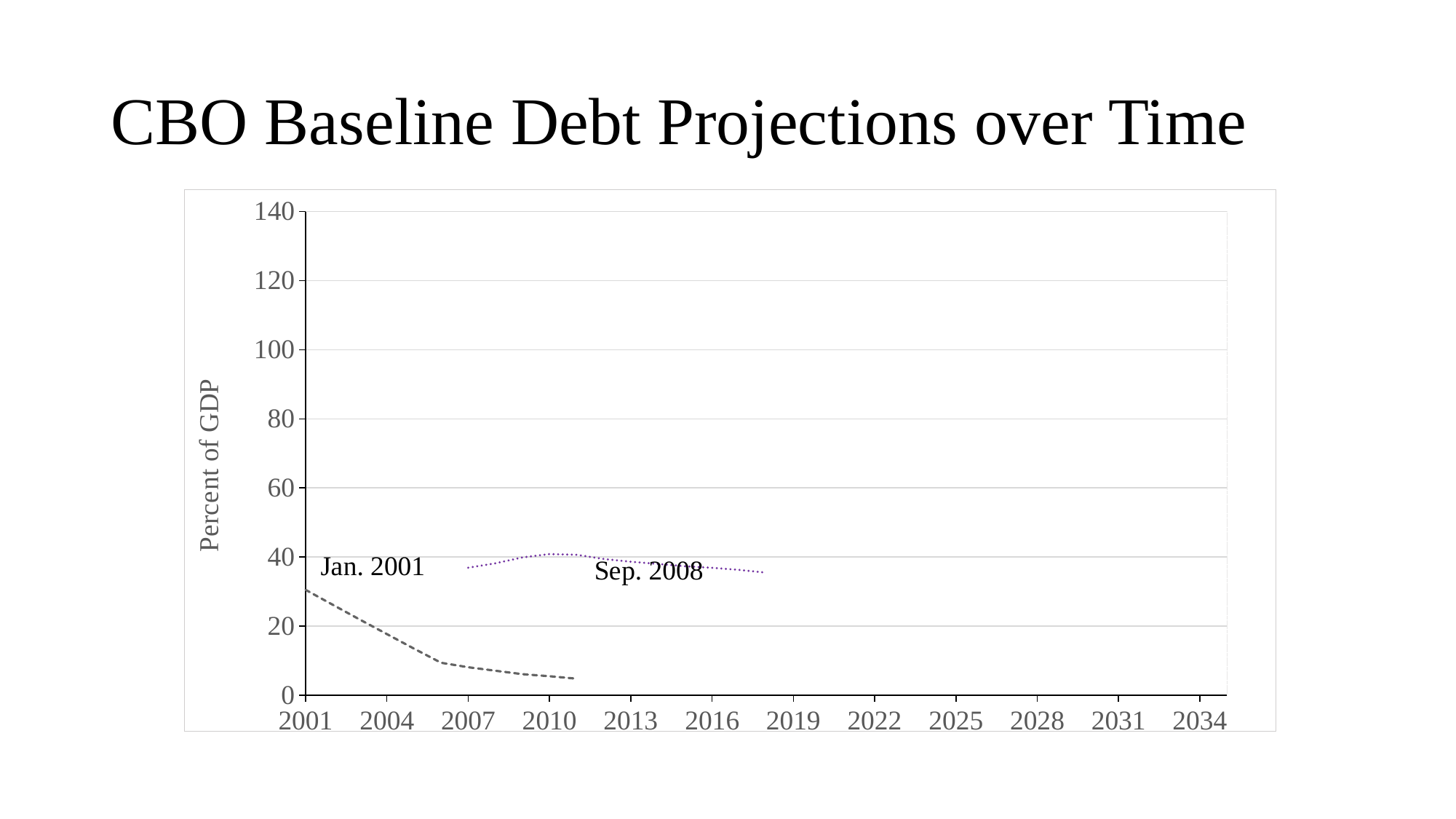
Is the Jan. 2001 projection value in 2010 greater or less than 20? less Is the Sep. 2008 projection value in 2018 greater or less than 60? less Is the Sep. 2008 projection value in 2010 greater or less than 20? greater What is the label on the vertical axis? Percent of GDP How many projection lines are plotted on the chart? 2 Which projection line reaches the highest value on the chart? Sep. 2008 In 2010, which projection is higher, Jan. 2001 or Sep. 2008? Sep. 2008 What kind of chart is shown on the slide? line chart Does the Jan. 2001 projection line rise or fall over time? fall Which projection line extends furthest to the right along the x axis? Sep. 2008 What is the title of the chart? CBO Baseline Debt Projections over Time